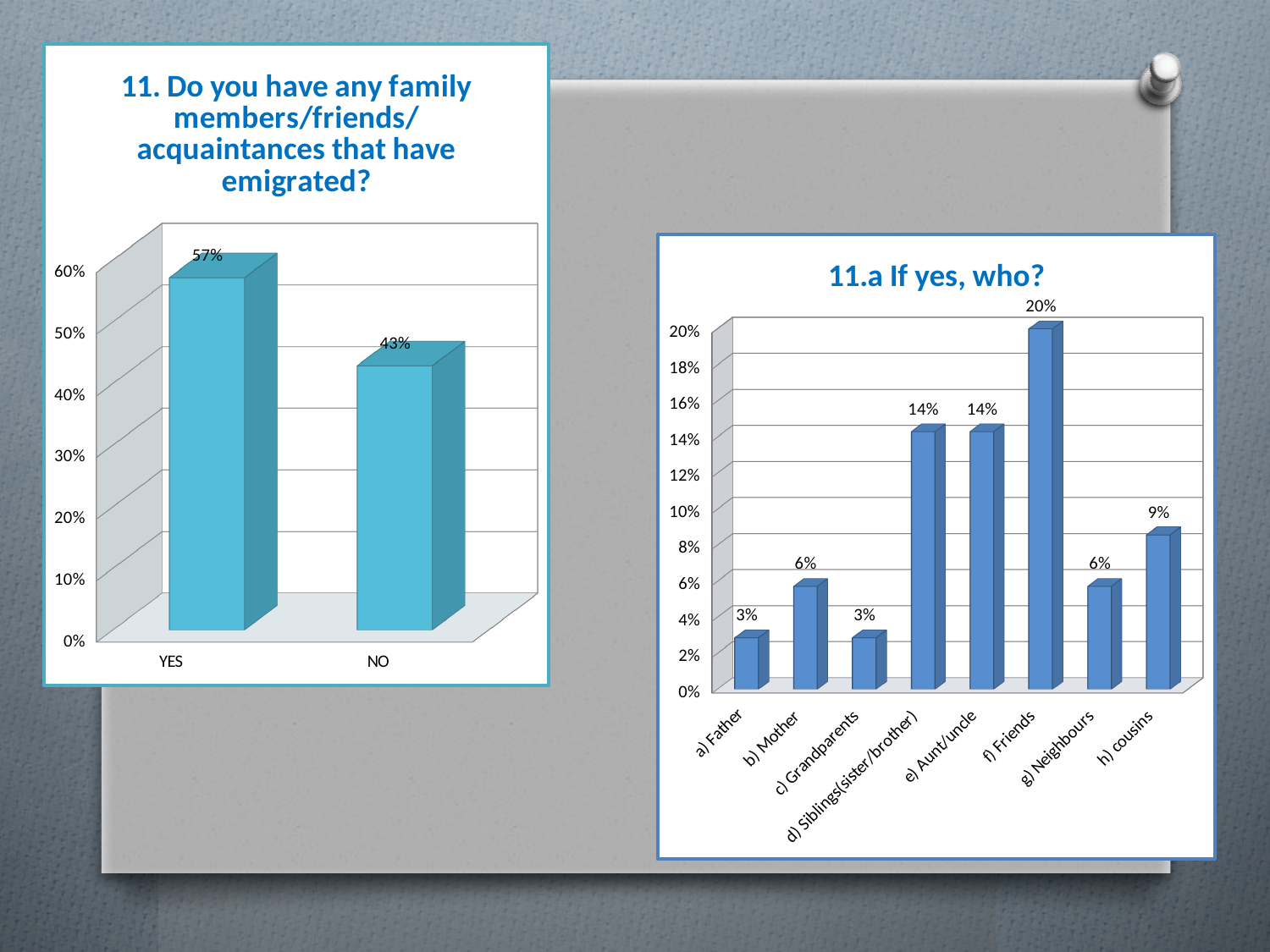
In the left chart, what is the difference between the YES and NO values? 14% What kind of chart is the chart titled "11.a If yes, who?"? Bar chart In the chart titled "11. Do you have any family members/friends/acquaintances that have emigrated?", what is the value for YES? 57% In the chart titled "11.a If yes, who?", what is the value for h) cousins? 9% In the chart titled "11.a If yes, who?", what is the value for f) Friends? 20% In the chart titled "11.a If yes, who?", what is the value for e) Aunt/uncle? 14% In the chart titled "11.a If yes, who?", what is the difference between the values for f) Friends and b) Mother? 14% In the chart titled "11.a If yes, who?", which is larger, the value for g) Neighbours or the value for h) cousins? h) cousins In the chart titled "11.a If yes, who?", which category has the highest value? f) Friends In the left chart, which is larger, YES or NO? YES In the chart titled "11.a If yes, who?", how many categories are shown on the x axis? 8 In the chart titled "11. Do you have any family members/friends/acquaintances that have emigrated?", what is the value for NO? 43%